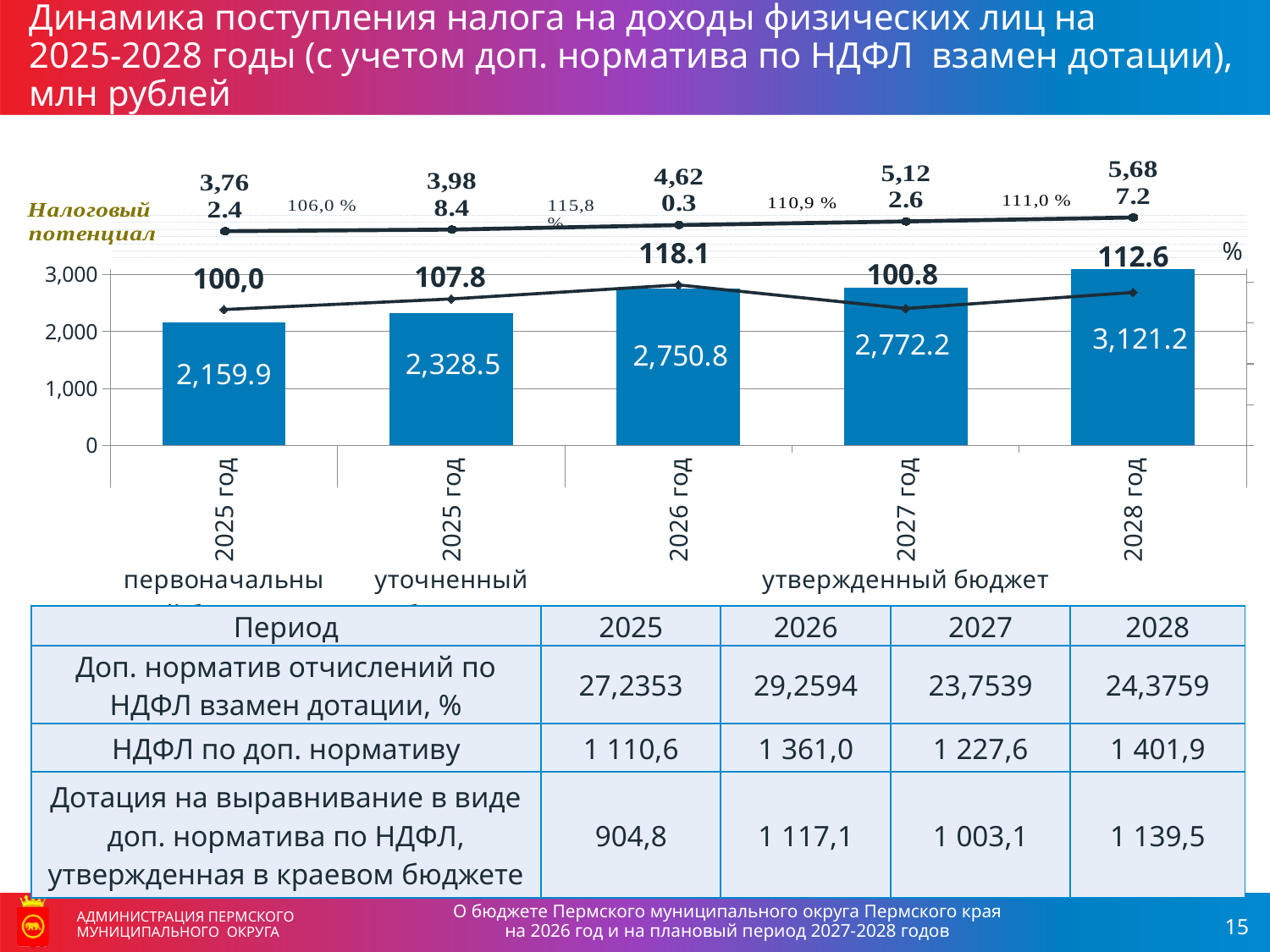
What is the value of the bar for 2028 год? 3,121.2 What is the difference between the bar values for 2028 год and 2026 год? 370.4 Which bar is the lowest? 2025 год (первоначальный бюджет), 2,159.9 What percentage is shown on the lower line above the 2026 год bar? 118.1 How many bars are shown in the chart? 5 Is the value of the first 2025 год bar greater or less than 3,000? less Which year has the highest bar? 2028 год What is the difference between the two 2025 год bars (уточненный minus первоначальный)? 168.6 Which bar is larger, 2027 год or 2026 год? 2027 год Do the bar values generally rise or fall from left to right? Rise What is the value of the bar for 2026 год? 2,750.8 What type of chart is used to show the НДФЛ values in млн рублей? Bar chart (with line overlays)